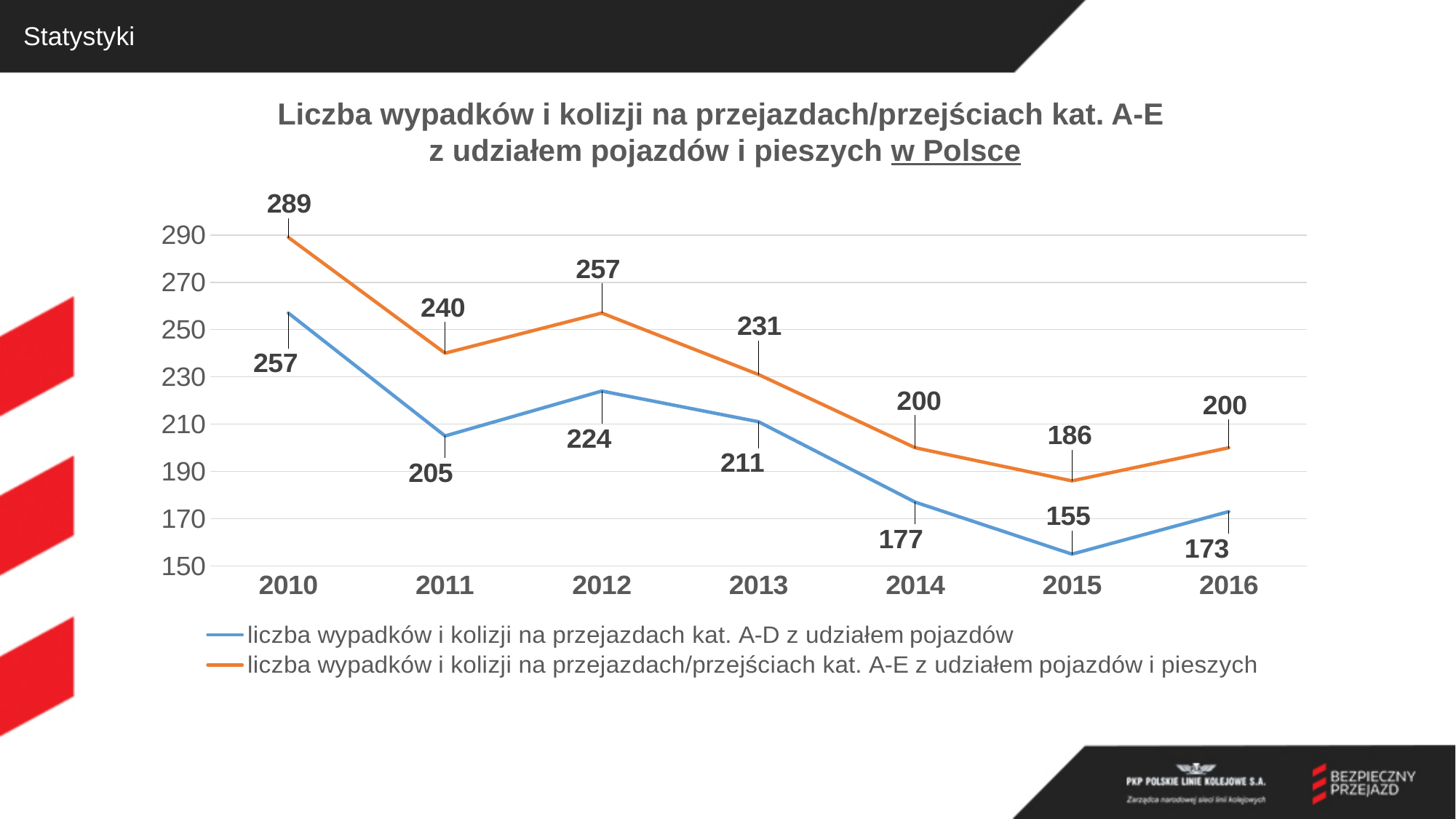
How many years are plotted along the x axis? 7 What is the value for 2015 in the series 'liczba wypadków i kolizji na przejazdach kat. A-D z udziałem pojazdów'? 155 What is the value for 2013 in the series 'liczba wypadków i kolizji na przejazdach kat. A-D z udziałem pojazdów'? 211 In which year is the series 'liczba wypadków i kolizji na przejazdach/przejściach kat. A-E z udziałem pojazdów i pieszych' lowest? 2015 How many series does the legend list? 2 Which is larger for the series 'liczba wypadków i kolizji na przejazdach kat. A-D z udziałem pojazdów': the value for 2012 or the value for 2013? 2012 What is the difference between the two series in 2016? 27 What colour is the line for the series 'liczba wypadków i kolizji na przejazdach kat. A-D z udziałem pojazdów'? blue What type of chart is shown on the slide? line chart In which year is the series 'liczba wypadków i kolizji na przejazdach kat. A-D z udziałem pojazdów' highest? 2010 Overall, do the values of the series 'liczba wypadków i kolizji na przejazdach/przejściach kat. A-E z udziałem pojazdów i pieszych' rise or fall from 2010 to 2016? fall What is the value for 2010 in the series 'liczba wypadków i kolizji na przejazdach/przejściach kat. A-E z udziałem pojazdów i pieszych'? 289